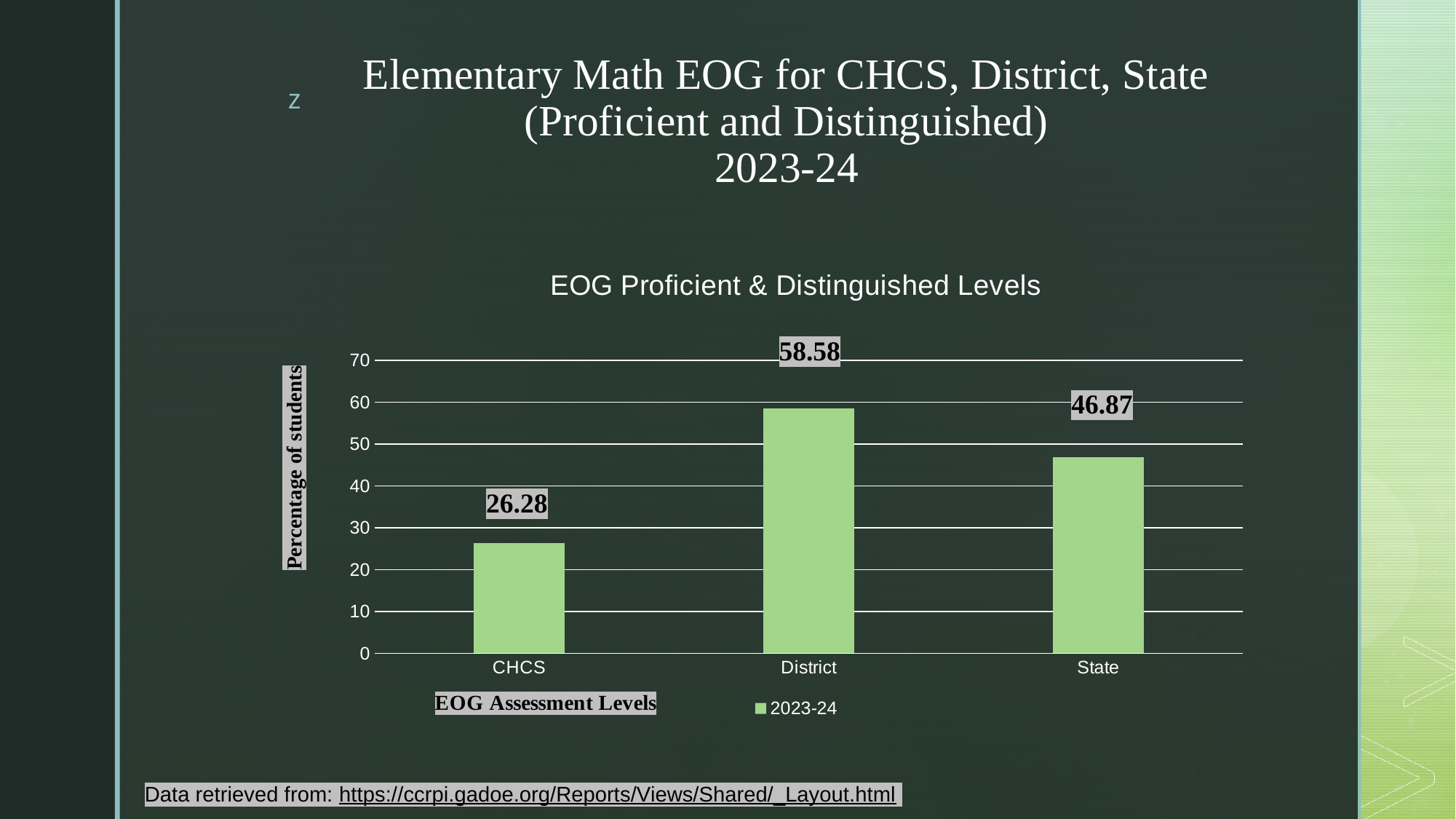
How many categories are shown on the x axis? 3 Which is larger, the value for State or the value for CHCS? State What is the value for State? 46.87 What is the difference between the State value and the CHCS value? 20.59 Which category has the highest value? District Is the value for State greater or less than 40? greater What is the value for CHCS? 26.28 What kind of chart is shown on the slide? bar chart Which category has the lowest value? CHCS What is the difference between the District value and the CHCS value? 32.30 What is the value for District? 58.58 What is the title of the chart? EOG Proficient & Distinguished Levels